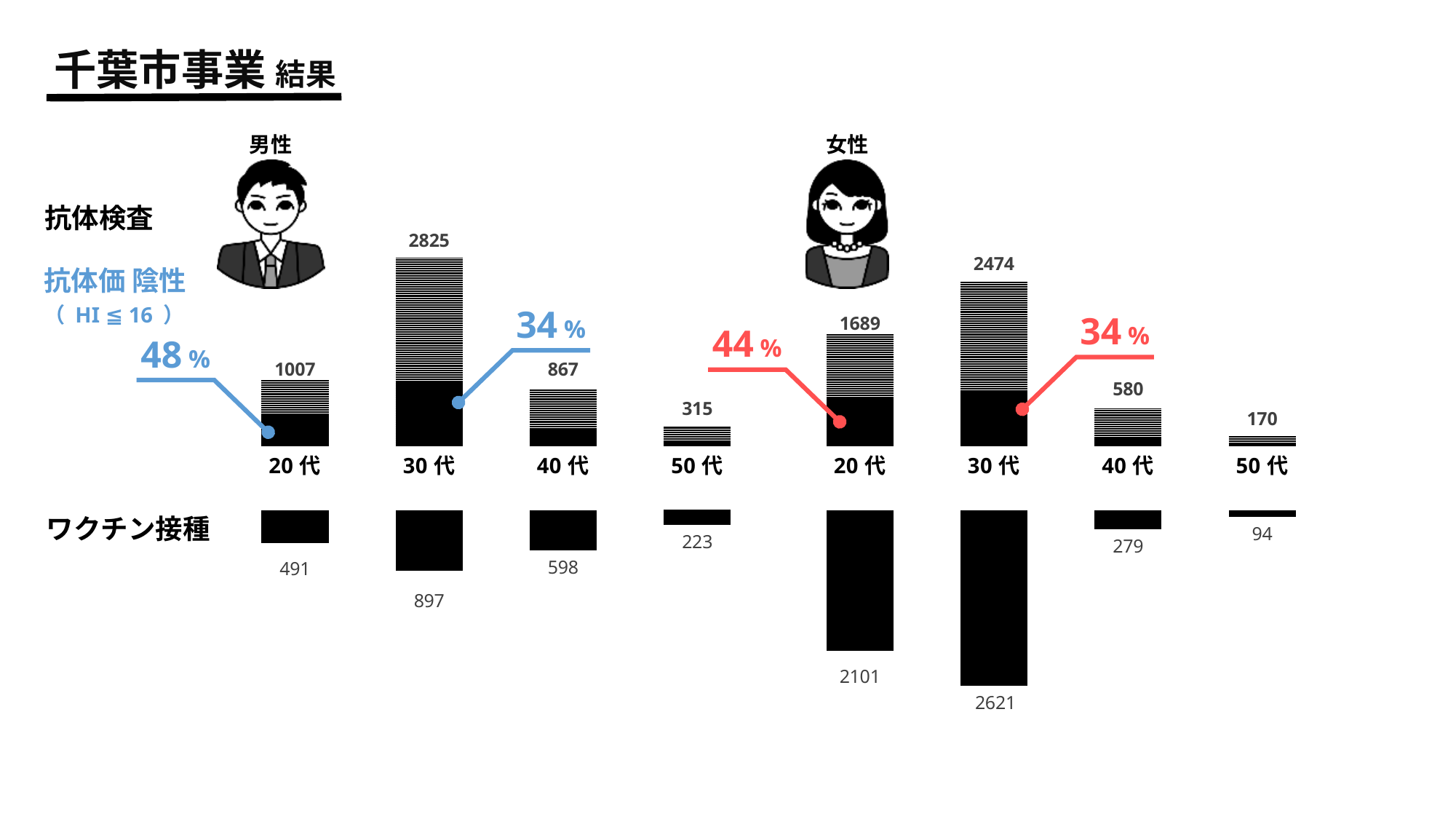
In the 抗体検査 chart, do the values for 女性 rise or fall from 30代 to 50代? fall In the 抗体検査 chart, which age group has the lowest value among 女性? 50代 In the 抗体検査 chart, which age group has the highest value among 男性? 30代 In the 抗体検査 chart, what percentage of 男性 20代 is labelled as 抗体価 陰性 (HI ≦ 16)? 48% In the ワクチン接種 (vaccination) chart, what is the value for 女性 30代? 2621 In the ワクチン接種 chart, what is the value for 男性 50代? 223 In the ワクチン接種 chart, which group has the highest value overall? 女性 30代 In the 抗体検査 chart, which is larger: 男性 40代 or 女性 40代? 男性 40代 In the 抗体検査 chart, what is the difference between 男性 30代 and 女性 30代? 351 In the 抗体検査 chart, what is the value for 女性 20代? 1689 In the 抗体検査 (antibody test) chart, what is the value for 男性 30代? 2825 In the ワクチン接種 chart, what is the difference between 女性 20代 and 男性 20代? 1610